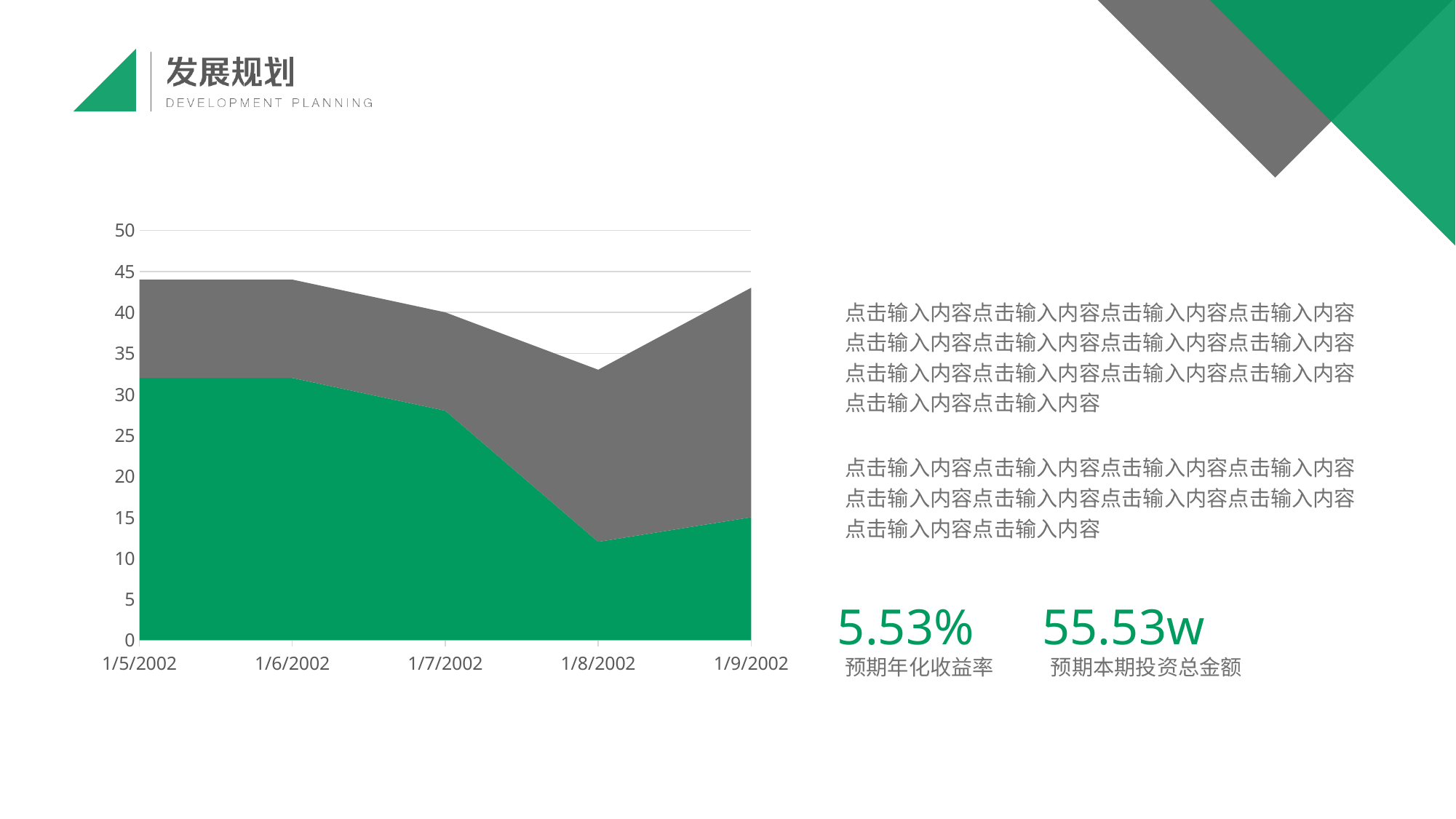
Is the top of the stacked area at 1/8/2002 greater or less than 35? less At which date is the top of the stacked area at its lowest? 1/8/2002 At which date is the green (bottom) series at its lowest? 1/8/2002 What kind of chart is shown on the slide? area chart Is the value of the green (bottom) series at 1/7/2002 greater or less than 25? greater Is the value of the green (bottom) series at 1/5/2002 greater or less than 30? greater How many dates are shown on the x axis of the chart? 5 Which is larger for the green (bottom) series: the value at 1/7/2002 or at 1/9/2002? 1/7/2002 Does the green (bottom) series rise or fall from 1/5/2002 to 1/8/2002? fall What is the highest value shown on the y axis of the chart? 50